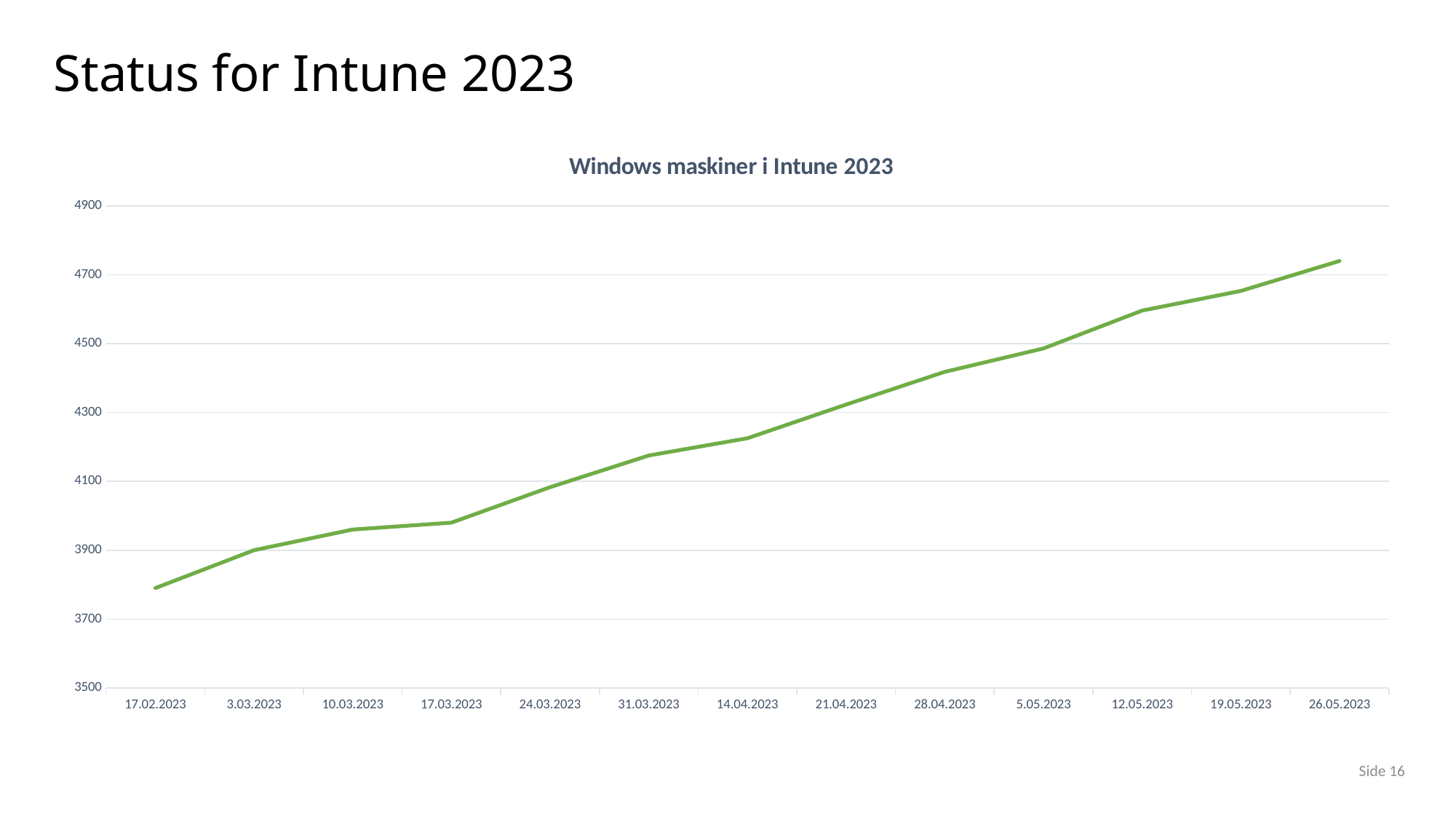
What is the title of the chart? Windows maskiner i Intune 2023 How many dates are plotted along the x axis of the chart? 13 What kind of chart is shown on the slide? line chart Is the value for 17.02.2023 greater or less than 3900? less Is the value for 28.04.2023 greater or less than 4500? less Is the value for 26.05.2023 greater or less than 4700? greater Do the values rise or fall from 17.02.2023 to 26.05.2023? rise Which date has the highest value on the chart? 26.05.2023 Which date has the lowest value on the chart? 17.02.2023 Which is larger, the value for 14.04.2023 or the value for 12.05.2023? 12.05.2023